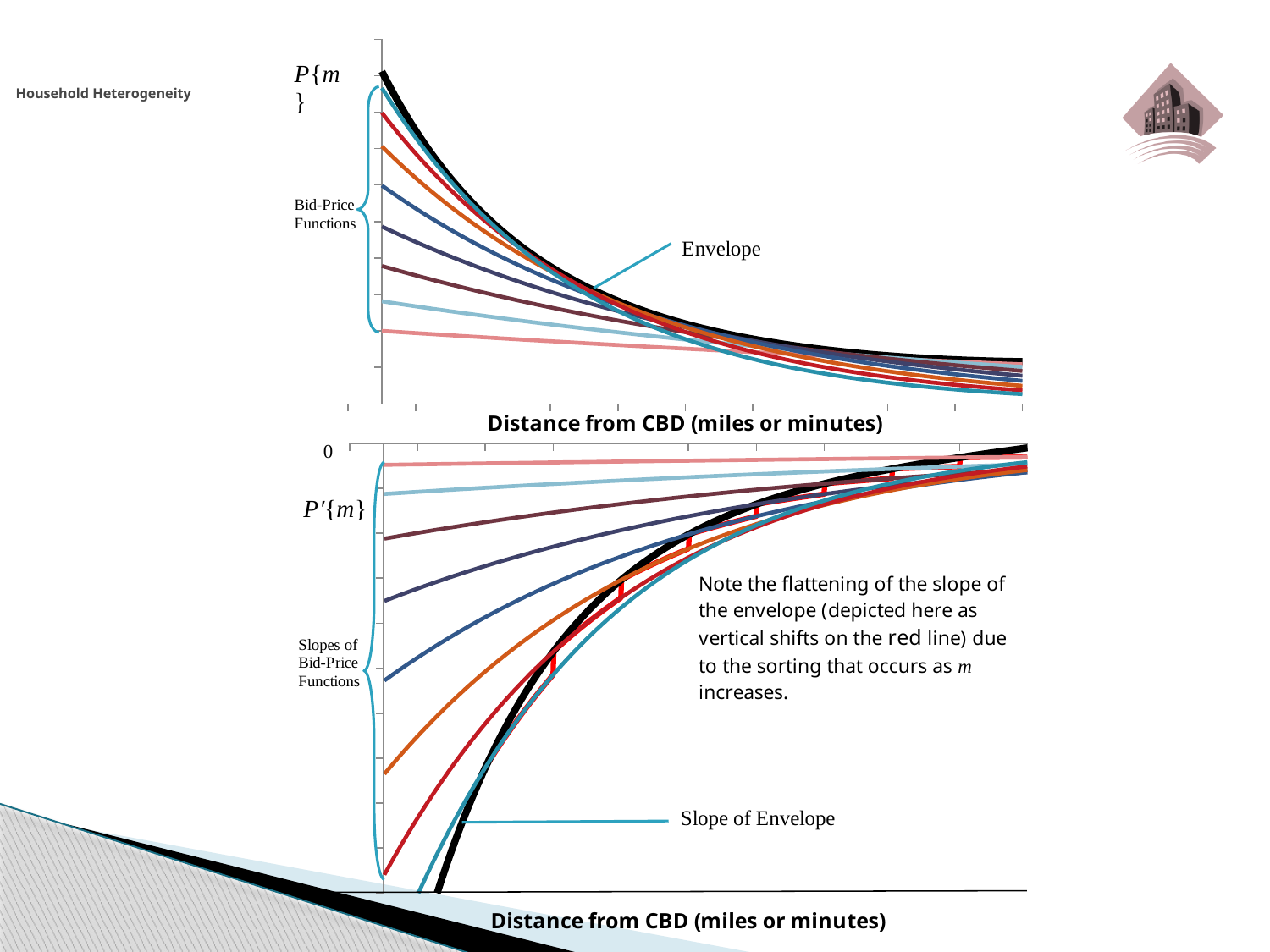
In the top chart, do the bid-price function lines rise or fall as distance from CBD increases? fall How many coloured bid-price function lines are plotted in the top chart (excluding the black envelope)? 8 What kind of chart is the bottom chart on the slide? line chart In the bottom chart, what label is given to the thick black line? Slope of Envelope In the bottom chart, do the slope lines rise or fall as distance from CBD increases? rise What is the x-axis label of the top chart? Distance from CBD (miles or minutes) In the top chart, does the black envelope line rise or fall along the x axis? fall How many coloured slope lines are plotted in the bottom chart (excluding the black envelope line)? 8 What kind of chart is the top chart on the slide? line chart